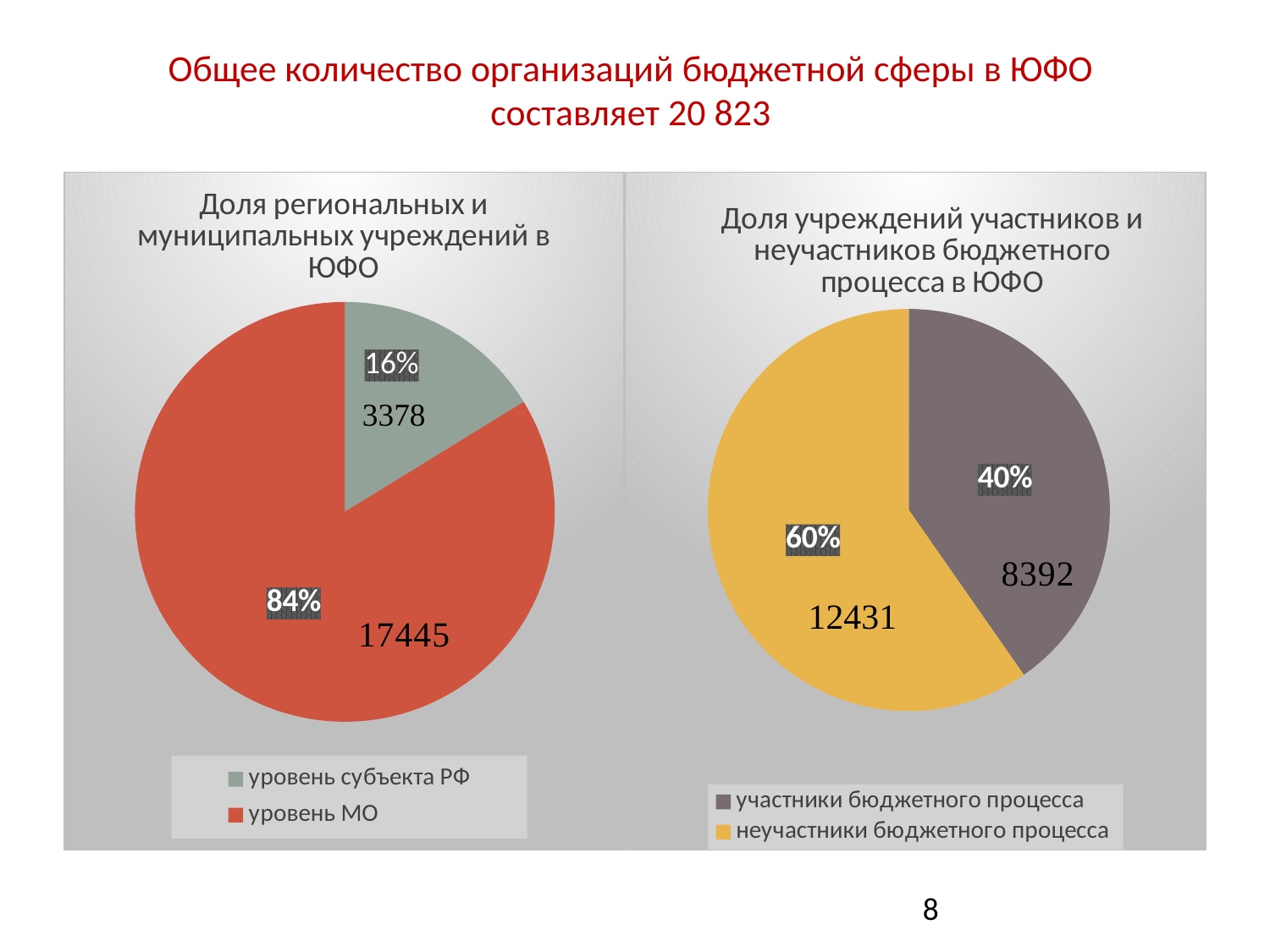
What type of chart is the left chart (Доля региональных и муниципальных учреждений в ЮФО)? pie chart In the right chart (Доля учреждений участников и неучастников бюджетного процесса в ЮФО), which is larger: «участники бюджетного процесса» or «неучастники бюджетного процесса»? неучастники бюджетного процесса In the left chart (Доля региональных и муниципальных учреждений в ЮФО), what value is shown for «уровень МО»? 17445 In the left chart (Доля региональных и муниципальных учреждений в ЮФО), which category is the largest? уровень МО In the right chart (Доля учреждений участников и неучастников бюджетного процесса в ЮФО), what value is shown for «участники бюджетного процесса»? 8392 In the left chart (Доля региональных и муниципальных учреждений в ЮФО), what share does «уровень МО» have? 84% In the right chart (Доля учреждений участников и неучастников бюджетного процесса в ЮФО), what value is shown for «неучастники бюджетного процесса»? 12431 In the right chart (Доля учреждений участников и неучастников бюджетного процесса в ЮФО), which category is the smallest? участники бюджетного процесса In the left chart (Доля региональных и муниципальных учреждений в ЮФО), what value is shown for «уровень субъекта РФ»? 3378 In the right chart (Доля учреждений участников и неучастников бюджетного процесса в ЮФО), what share do «участники бюджетного процесса» have? 40% How many categories does the right chart (Доля учреждений участников и неучастников бюджетного процесса в ЮФО) show? 2 In the left chart (Доля региональных и муниципальных учреждений в ЮФО), what is the difference between the values for «уровень МО» and «уровень субъекта РФ»? 14067